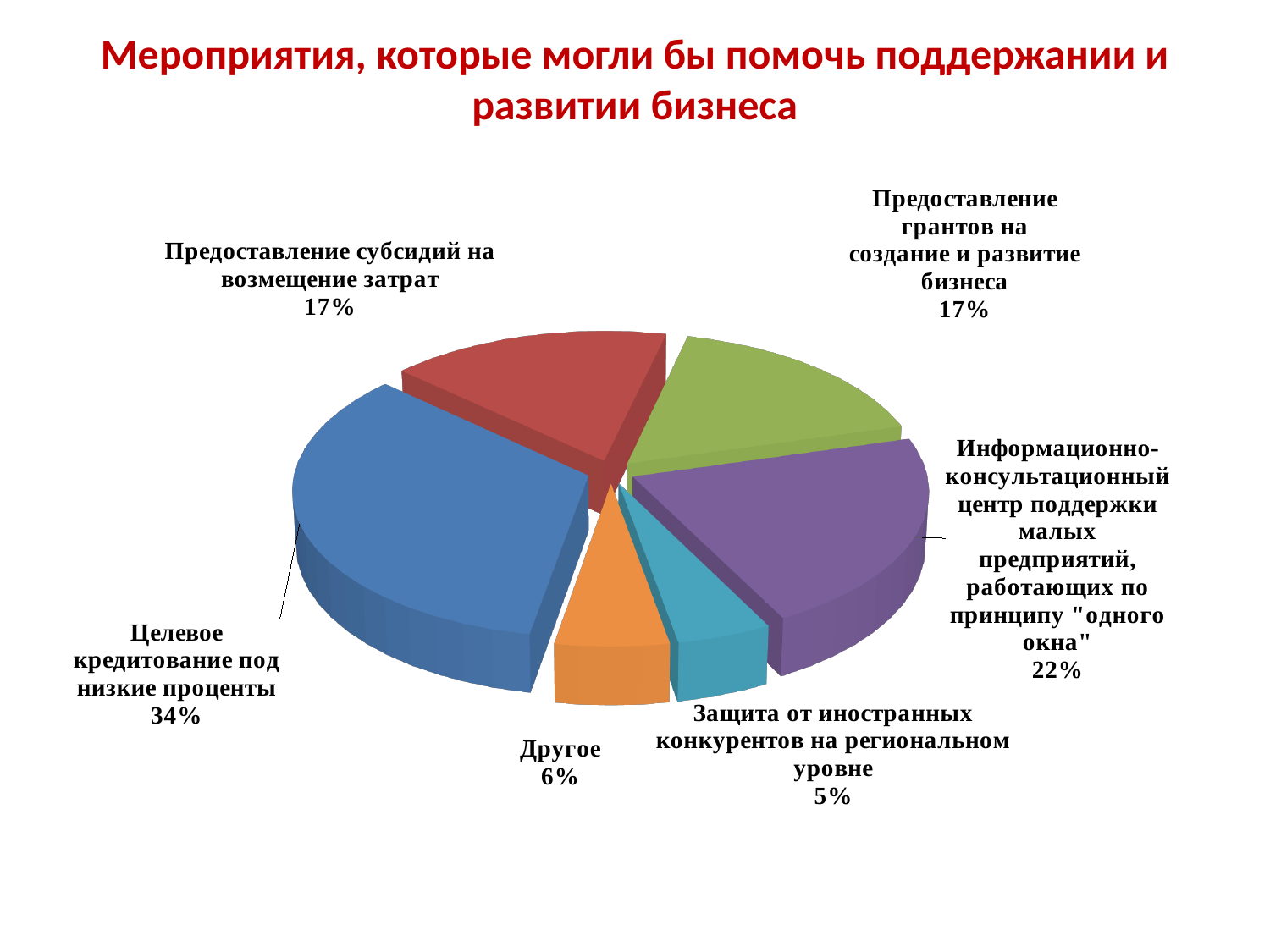
What is the title of the slide? Мероприятия, которые могли бы помочь поддержании и развитии бизнеса What share does "Предоставление субсидий на возмещение затрат" have? 17% Which category has the largest share of the pie? Целевое кредитование под низкие проценты Which is larger: the share for "Другое" or the share for "Защита от иностранных конкурентов на региональном уровне"? Другое What is the difference in percentage points between "Целевое кредитование под низкие проценты" and "Информационно-консультационный центр поддержки малых предприятий, работающих по принципу "одного окна""? 12 percentage points What share does "Защита от иностранных конкурентов на региональном уровне" have? 5% What kind of chart is shown on the slide? Pie chart What share does "Другое" have in the pie chart? 6% What share does "Целевое кредитование под низкие проценты" have in the pie chart? 34% What share does "Информационно-консультационный центр поддержки малых предприятий, работающих по принципу "одного окна"" have? 22% Which category has the smallest share of the pie? Защита от иностранных конкурентов на региональном уровне How many categories (slices) does the pie chart have? 6